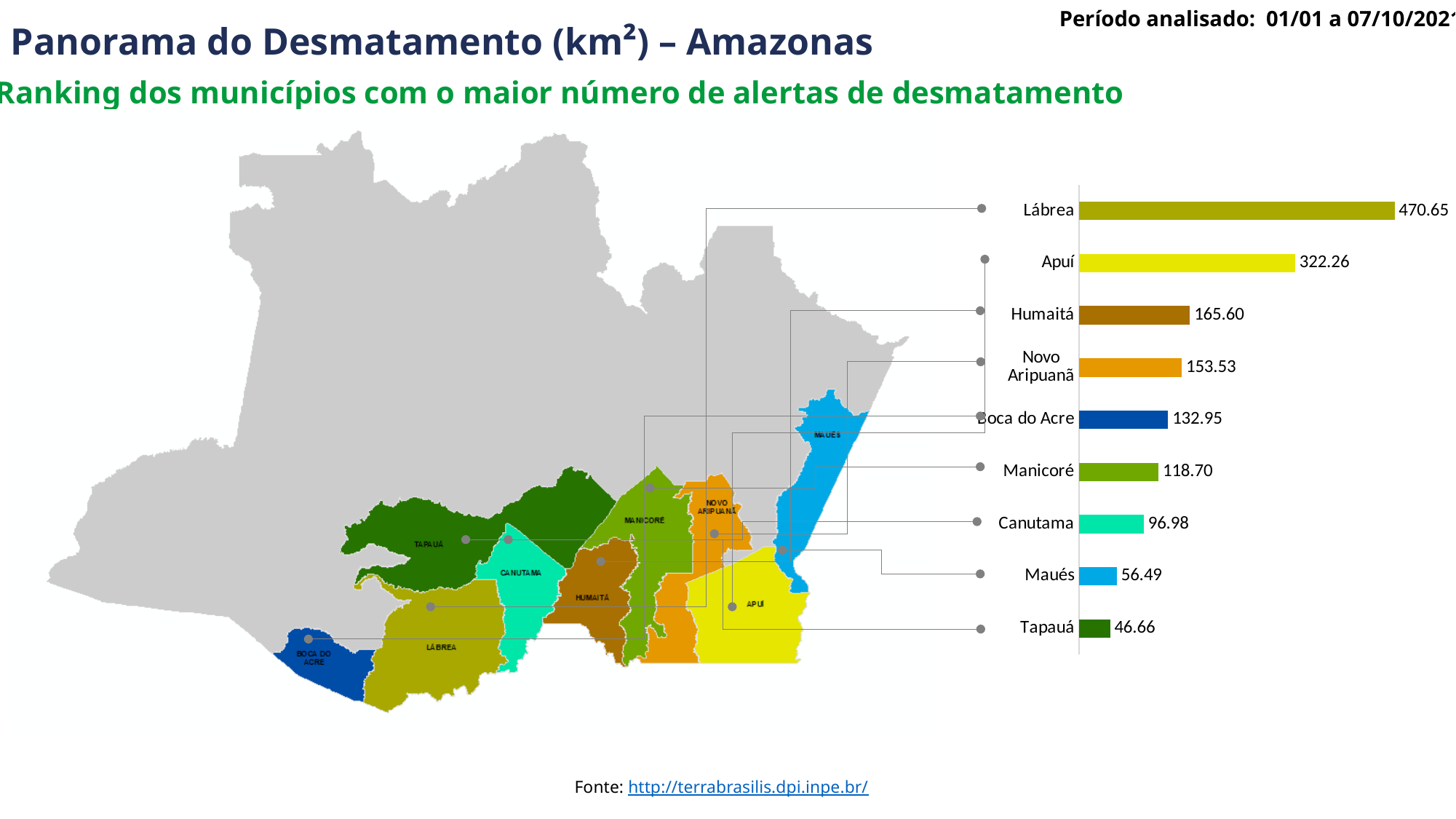
What is the value shown for Lábrea in the bar chart? 470.65 What is the value shown for Novo Aripuanã in the bar chart? 153.53 What is the difference between the values for Canutama and Maués? 40.49 Which has a larger value, Manicoré or Canutama? Manicoré How many municipalities are shown in the bar chart? 9 Which municipality has the highest value in the bar chart? Lábrea What is the difference between the values for Lábrea and Apuí? 148.39 What is the value shown for Maués in the bar chart? 56.49 What is the value shown for Boca do Acre in the bar chart? 132.95 Which municipality has the lowest value in the bar chart? Tapauá What kind of chart is used to rank the municipalities? Bar chart Which has a larger value, Humaitá or Boca do Acre? Humaitá